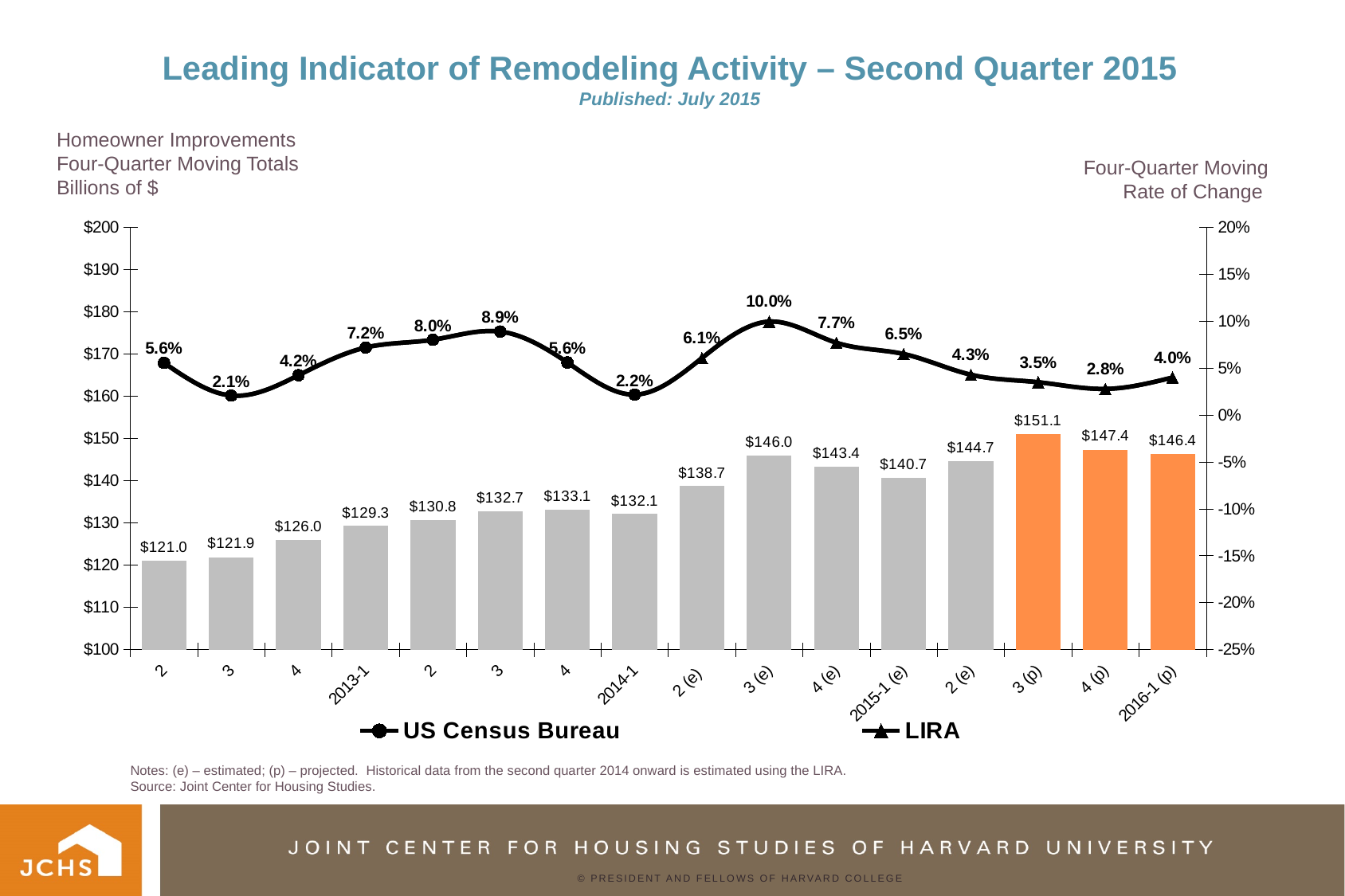
How many bars are plotted on the chart? 16 What is the highest rate of change shown on the line? 10.0% What is the rate of change shown for 2015-1 (e)? 6.5% What is the lowest rate of change shown on the line? 2.1% What is the lowest bar value shown on the chart? $121.0 Which quarter has the highest bar value, and what is it? 3 (p), $151.1 What is the projected homeowner improvements value for 2016-1 (p)? $146.4 What is the four-quarter moving rate of change shown for 2014-1? 2.2% Which has the larger bar value, 2013-1 or 2014-1? 2014-1 How many series does the legend list? 2 What is the difference between the bar values for 3 (p) and 4 (p)? $3.7 What is the homeowner improvements value (bar) for 2013-1? $129.3